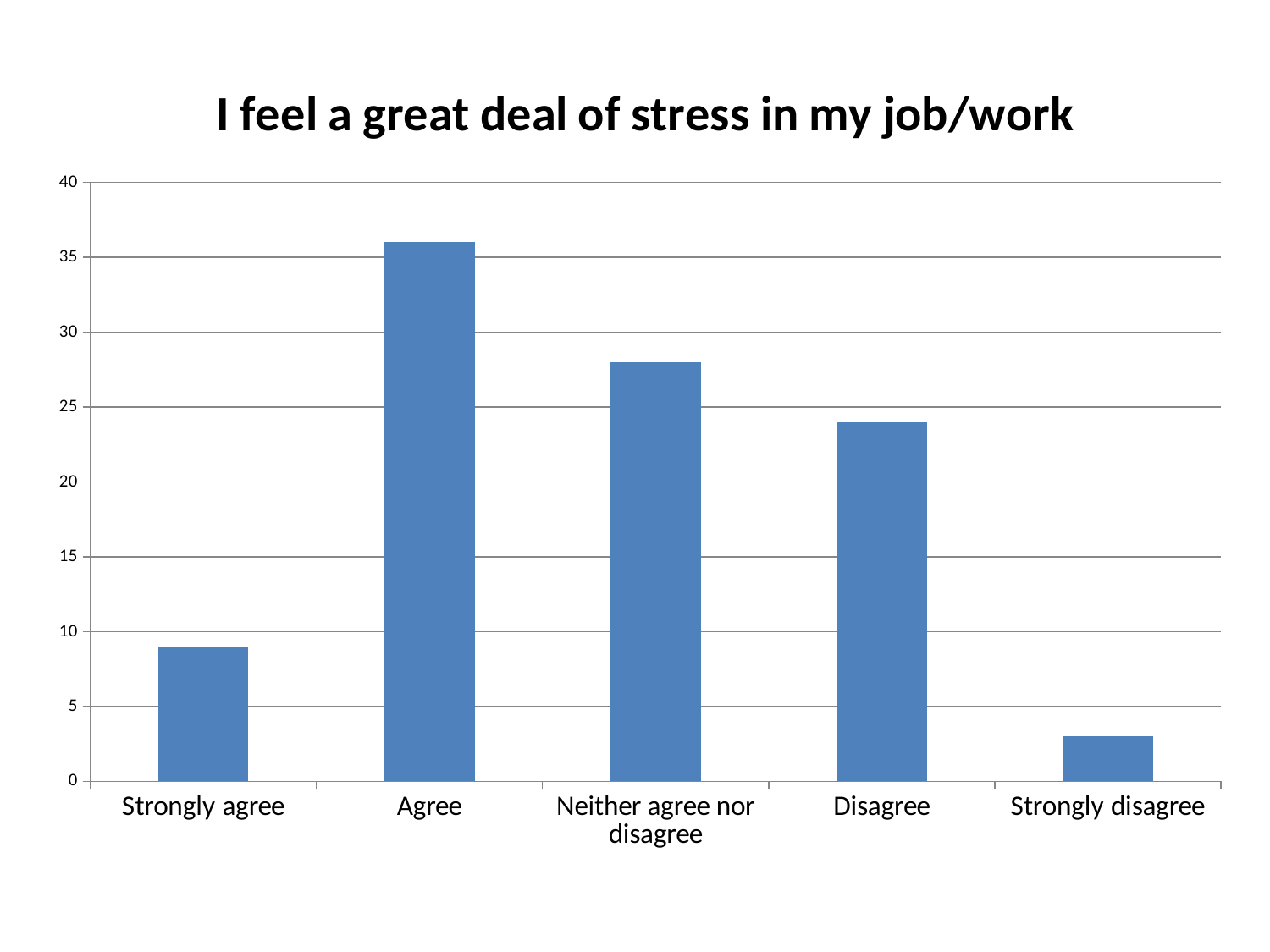
What kind of chart is shown on the slide? bar chart Which is larger, the value for Neither agree nor disagree or the value for Disagree? Neither agree nor disagree Is the value for Strongly disagree greater or less than 5? less Is the value for Agree greater or less than 35? greater What is the title of the chart? I feel a great deal of stress in my job/work Which is larger, the value for Strongly agree or the value for Strongly disagree? Strongly agree Is the value for Disagree greater or less than 25? less Which category has the lowest value? Strongly disagree Which category has the highest value? Agree How many categories are shown on the x axis? 5